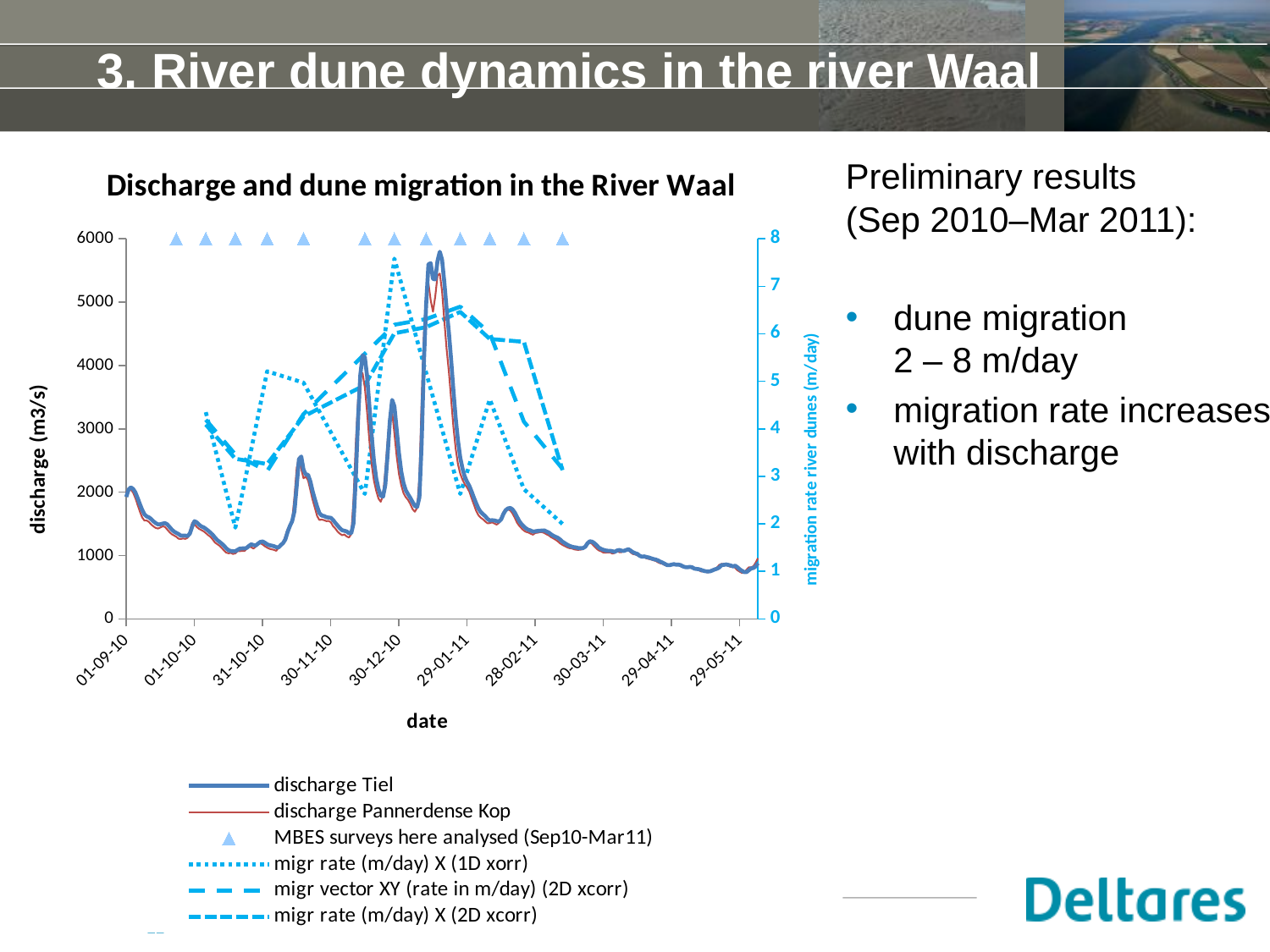
What is the title of the chart on the slide? Discharge and dune migration in the River Waal Which series reaches a higher peak discharge, discharge Tiel or discharge Pannerdense Kop? discharge Tiel Does the discharge Tiel series rise or fall between 29-01-11 and 29-05-11? fall What kind of chart is shown on the slide? line chart How many series does the chart's legend list? 6 Is the discharge Tiel value at 31-10-10 greater or less than 2000? less How many MBES survey markers (triangles) are plotted along the top of the chart? 12 Is the peak value of the discharge Tiel series greater or less than 5000? greater What is the label of the left vertical axis of the chart? discharge (m3/s) Is the highest value of the migr rate (m/day) X (1D xorr) series greater or less than 7 on the right axis? greater